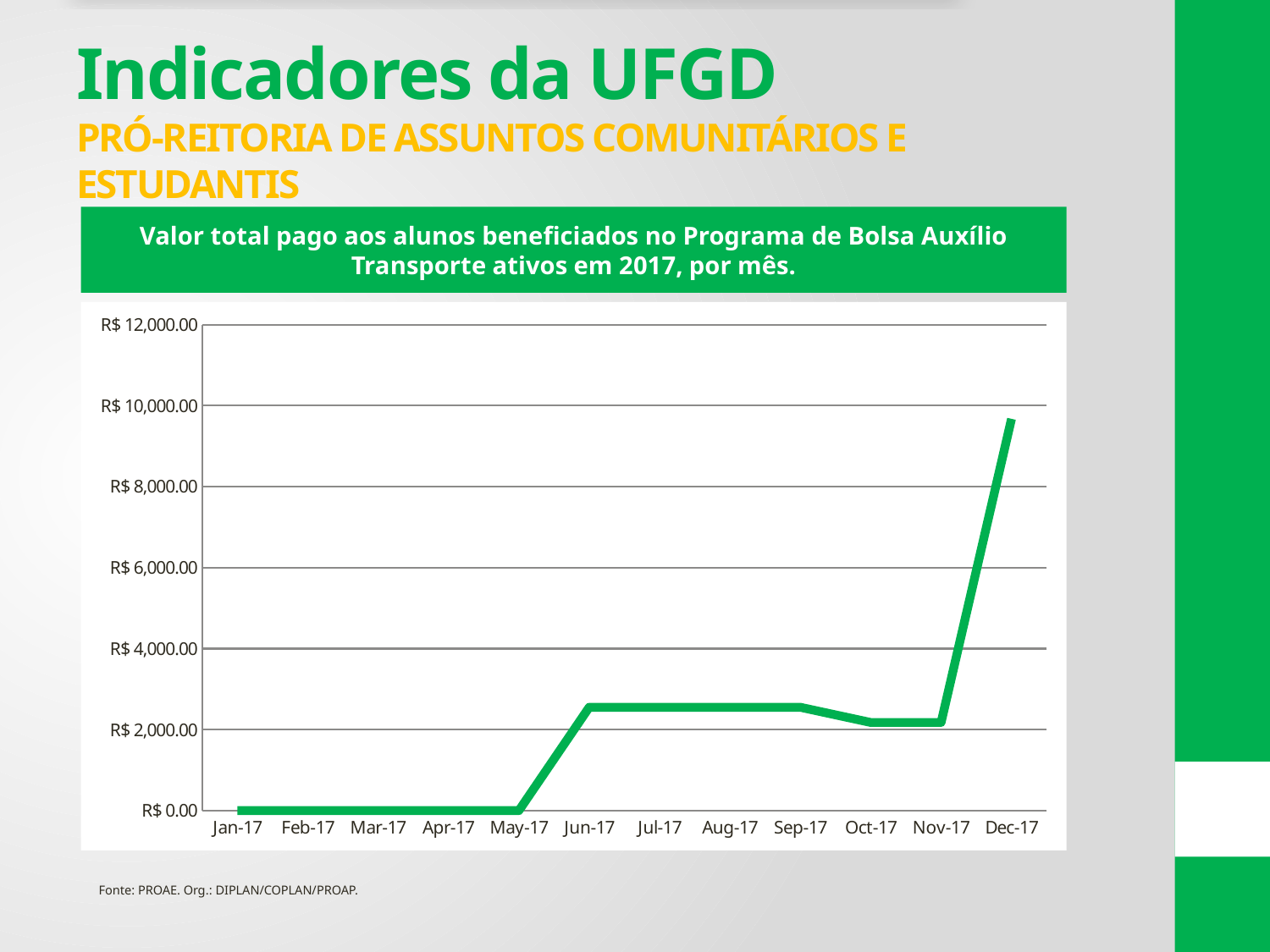
Which month has the highest value paid? Dec-17 Which is larger, the value for Jul-17 or the value for Mar-17? Jul-17 Which is larger, the value for Dec-17 or the value for Jun-17? Dec-17 What is the title of the chart? Valor total pago aos alunos beneficiados no Programa de Bolsa Auxílio Transporte ativos em 2017, por mês. How many months are plotted along the x axis? 12 Is the value for Aug-17 greater or less than R$ 4,000.00? less Is the value for Nov-17 greater or less than R$ 4,000.00? less What kind of chart is shown on the slide? line chart Is the value for Jun-17 greater or less than R$ 2,000.00? greater Does the value rise or fall from Nov-17 to Dec-17? rise What is the highest value shown on the y axis? R$ 12,000.00